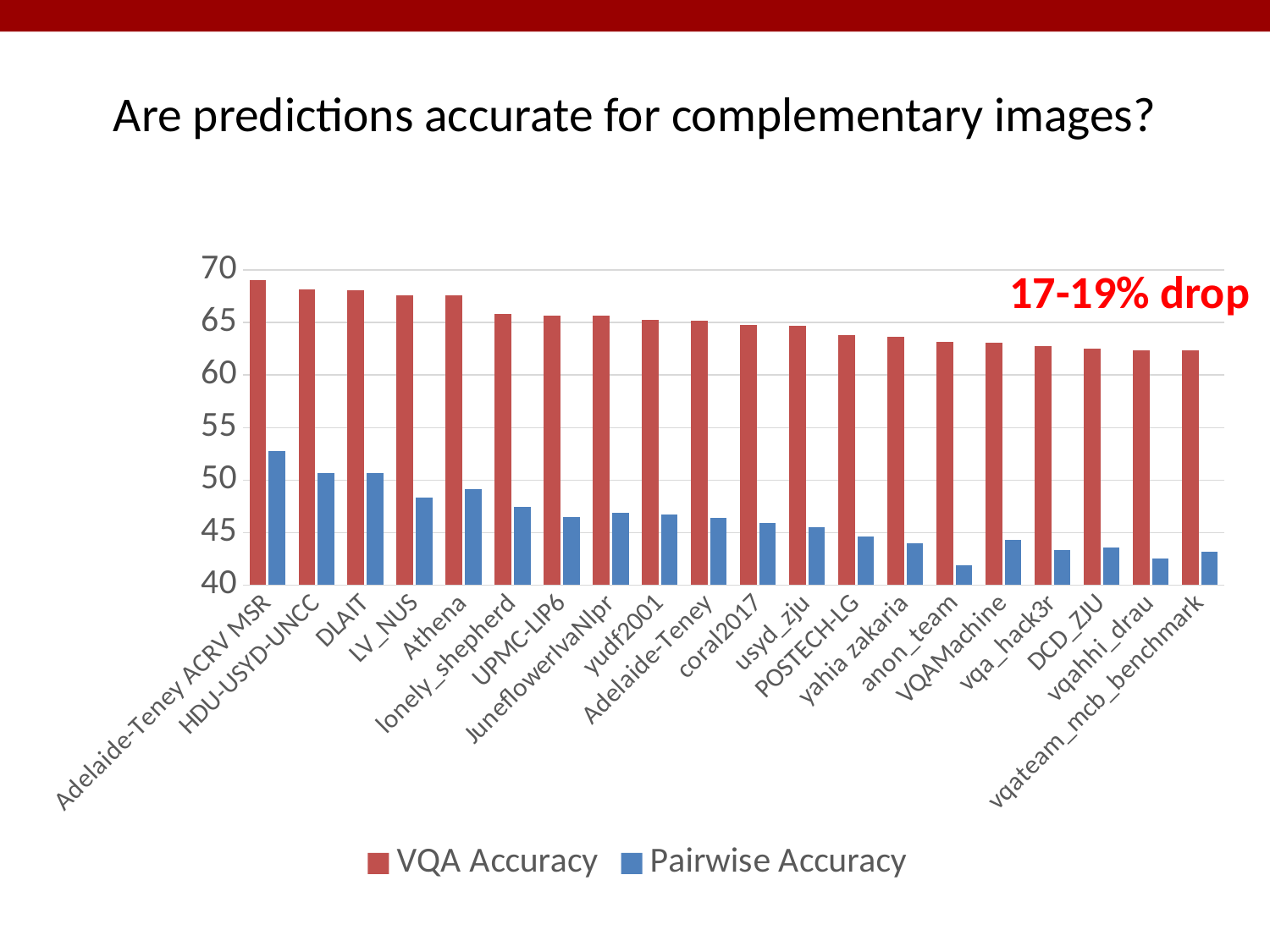
For DLAIT, which is larger: VQA Accuracy or Pairwise Accuracy? VQA Accuracy Which team has the highest VQA Accuracy? Adelaide-Teney ACRV MSR Is the Pairwise Accuracy for LV_NUS greater or less than 50? less Is the VQA Accuracy for vqateam_mcb_benchmark greater or less than 65? less Which team has the lowest Pairwise Accuracy? anon_team Is the Pairwise Accuracy for anon_team greater or less than 45? less How many teams (categories) are shown on the x axis? 20 Which team has the highest Pairwise Accuracy? Adelaide-Teney ACRV MSR Do the VQA Accuracy values rise or fall moving left to right along the x axis? fall How many series does the legend list? 2 What kind of chart is shown on the slide? bar chart